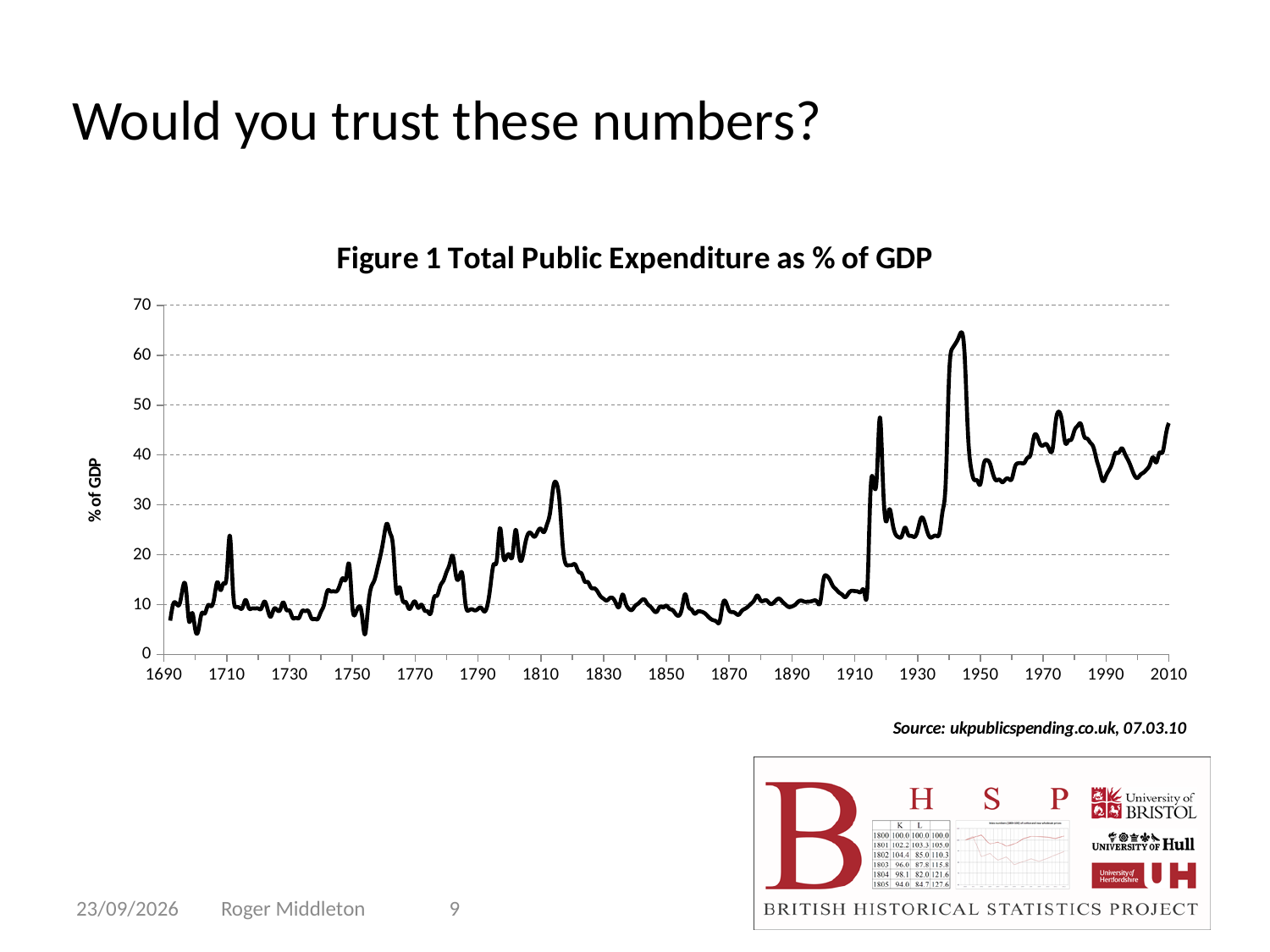
Is the value for 1944 greater or less than 60? greater Which is larger, the value for 1944 or the value for 1815? 1944 Is the value for 1850 greater or less than 20? less What is the label on the vertical axis of the chart? % of GDP Is the value for 2010 greater or less than 40? greater In which decade does the line reach its highest point? 1940s How many lines (data series) are plotted on the chart? 1 What kind of chart is shown on the slide? line chart What is the title of the chart? Figure 1 Total Public Expenditure as % of GDP Between 1830 and 1870, does the line generally rise or fall? fall